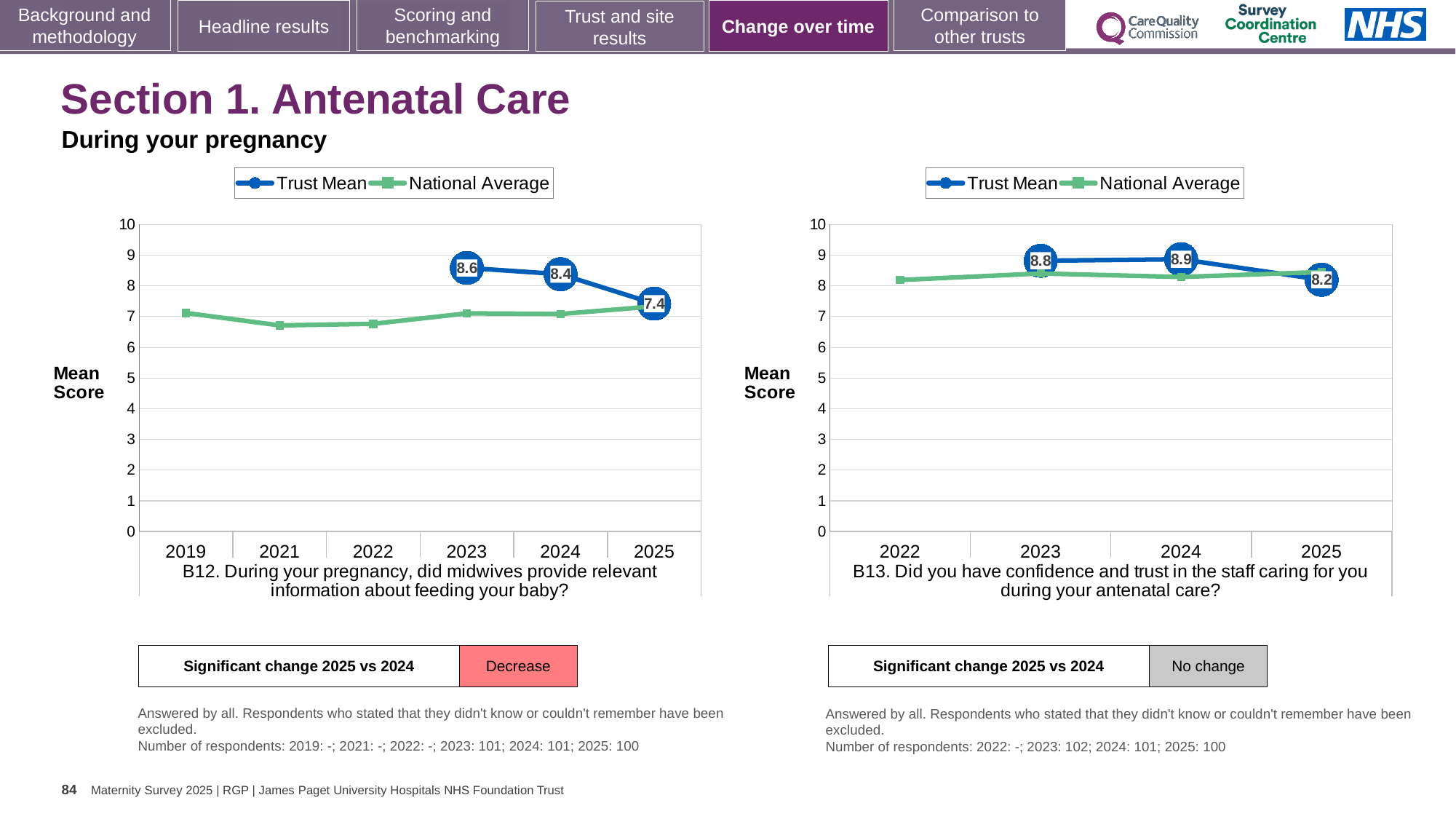
How many series does the legend of the B13 chart (right) list? 2 In the B12 chart (left), is the National Average for 2021 greater or less than 7? less In the B13 chart (right), is the Trust Mean higher in 2023 or in 2025? 2023 In the B12 chart (left), which year has the lowest Trust Mean? 2025 In the B13 chart (right), what is the Trust Mean for 2024? 8.9 In the B13 chart (right), what is the Trust Mean for 2025? 8.2 In the B12 chart (left), what is the Trust Mean for 2025? 7.4 How many years are shown on the x axis of the B12 chart (left)? 6 In the B13 chart (right), which year has the highest Trust Mean? 2024 In the B12 chart (left), what is the difference between the Trust Mean in 2024 and in 2025? 1.0 In the B12 chart (left), what is the Trust Mean for 2023? 8.6 What kind of chart is the B13 chart (right)? Line chart